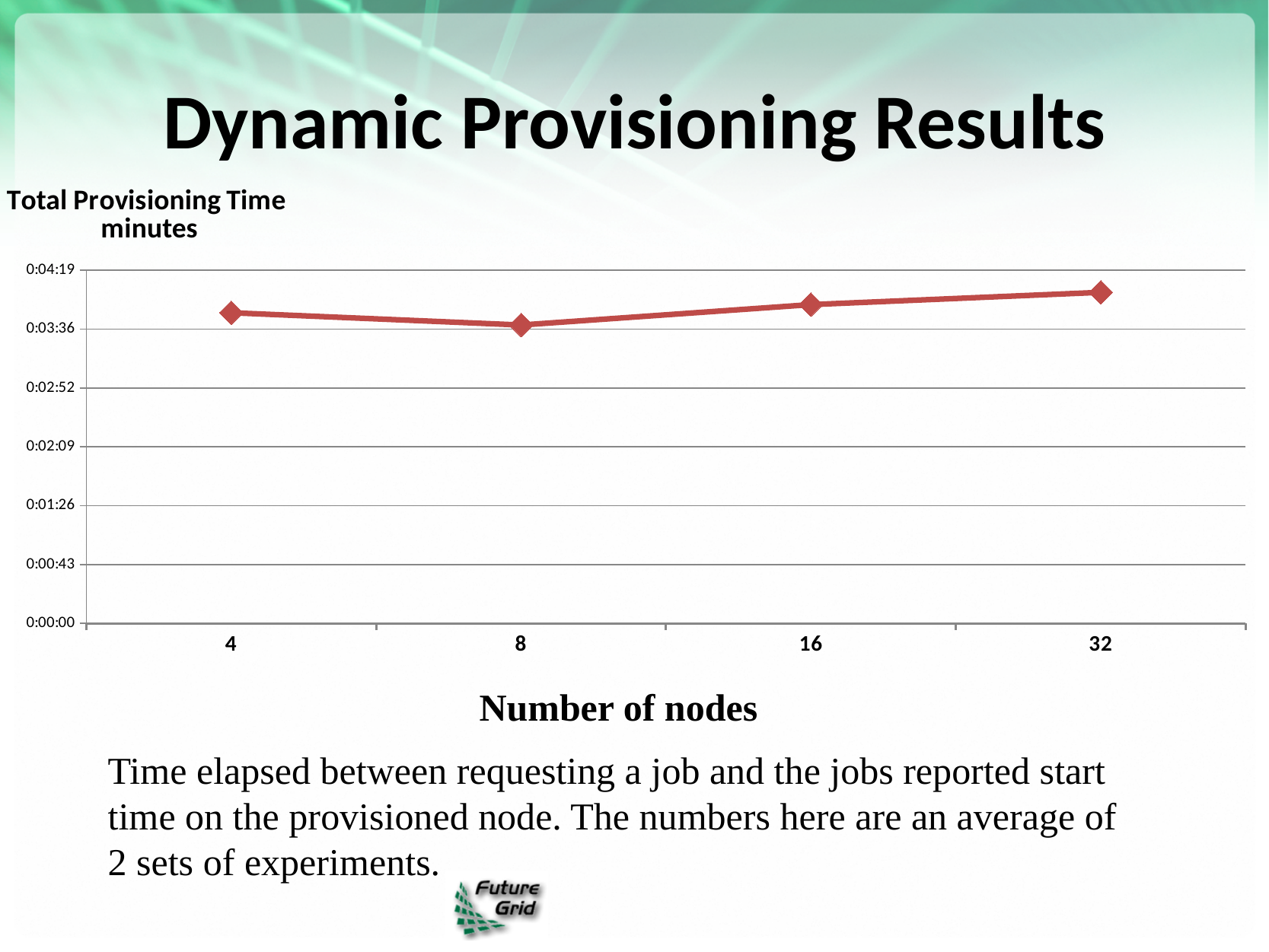
How many data points are plotted on the line? 4 Which has a higher total provisioning time, 16 nodes or 32 nodes? 32 nodes Which number of nodes has the highest total provisioning time? 32 Does the total provisioning time rise or fall from 8 nodes to 32 nodes? rises What is the label of the x axis? Number of nodes What kind of chart is shown on the slide? line chart What is the title of the chart? Total Provisioning Time minutes Is the total provisioning time for 4 nodes greater or less than 0:03:36? greater Which has a higher total provisioning time, 4 nodes or 8 nodes? 4 nodes Which number of nodes has the lowest total provisioning time? 8 Is the total provisioning time for 32 nodes greater or less than 0:04:19? less Is the total provisioning time for 8 nodes greater or less than 0:02:52? greater